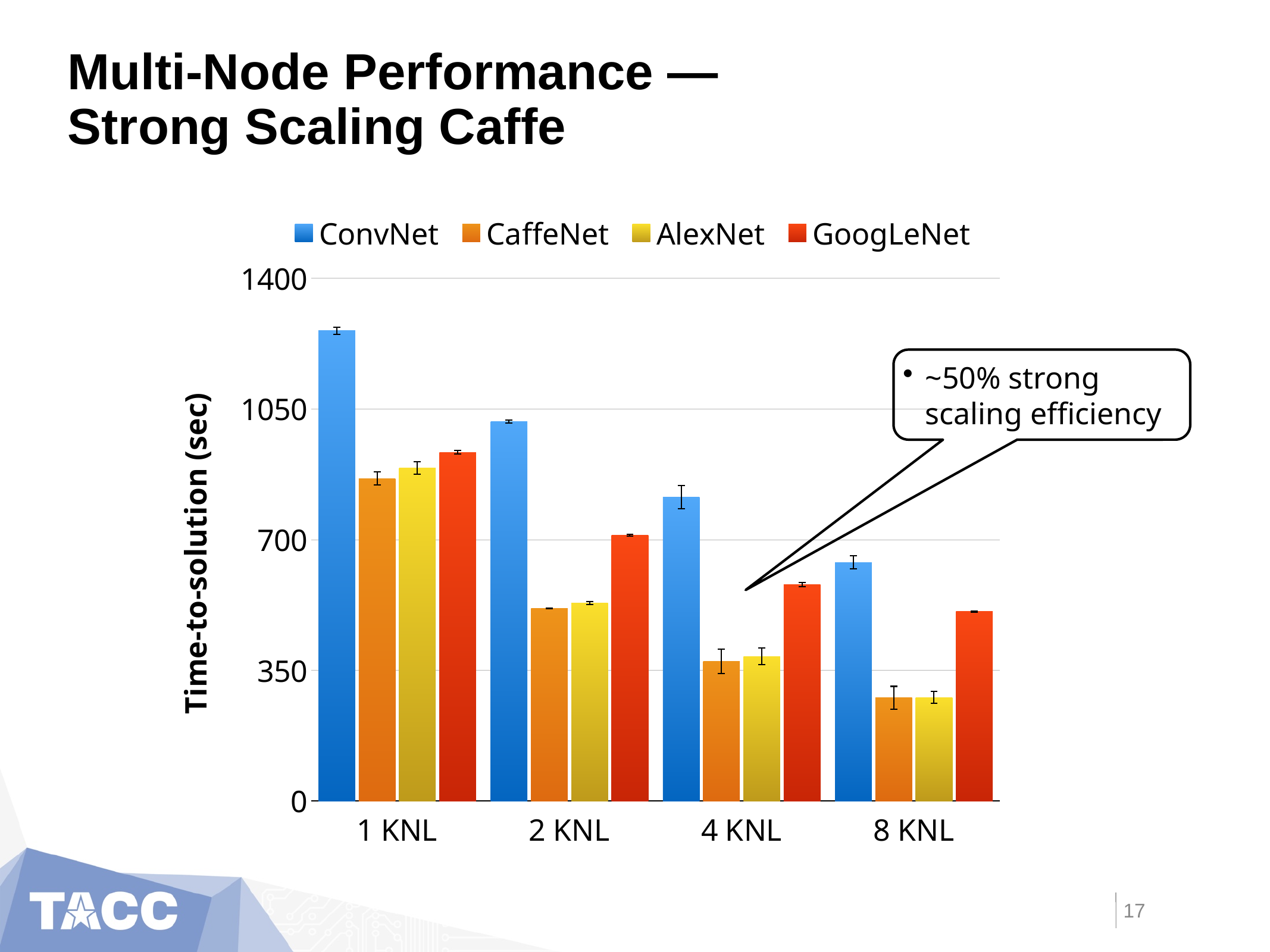
How many series does the legend list? 4 Which series has the highest bar at 8 KNL? ConvNet Is the ConvNet value at 4 KNL greater or less than 700? greater Which series has the highest bar at 1 KNL? ConvNet Which is larger: the GoogLeNet value at 2 KNL or the GoogLeNet value at 4 KNL? 2 KNL Is the GoogLeNet value at 8 KNL greater or less than 350? greater Is the ConvNet value at 1 KNL greater or less than 1050? greater What is the label of the y axis? Time-to-solution (sec) What kind of chart is shown on the slide? bar chart How many node-count categories are shown on the x axis? 4 Do the ConvNet values rise or fall as the number of KNL nodes increases from 1 to 8? fall